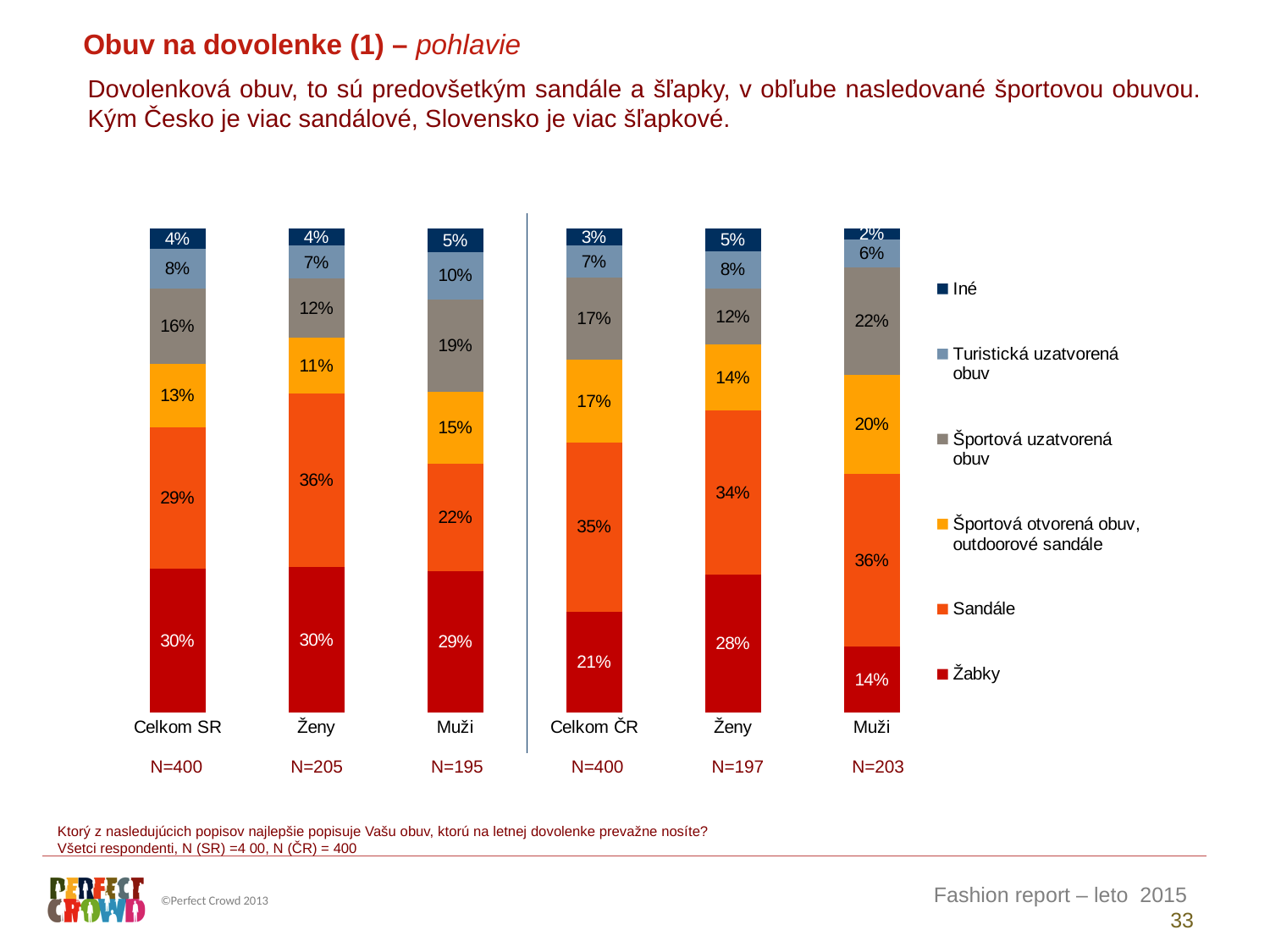
Which legend entry is shown in dark red at the bottom of each bar? Žabky What is the value for Sandále in the Celkom ČR bar? 35% How many bars (categories) are plotted in the chart? 6 Which is larger: the Sandále value for Ženy on the SR side (N=205) or for Ženy on the ČR side (N=197)? Ženy SR (36%) What kind of chart is shown on the slide? stacked bar chart What is the value for Žabky in the Celkom SR bar? 30% How many series does the legend list? 6 Which bar has the highest value for Sandále? Muži (ČR, N=203) and Ženy (SR, N=205), both 36% What is the difference between the Žabky value for Celkom SR and for Celkom ČR? 9 percentage points What is the value for Turistická uzatvorená obuv in the Muži bar on the SR side (N=195)? 10% What is the value for Športová uzatvorená obuv in the Muži bar on the ČR side (N=203)? 22% Which bar has the lowest value for Žabky? Muži (ČR, N=203)